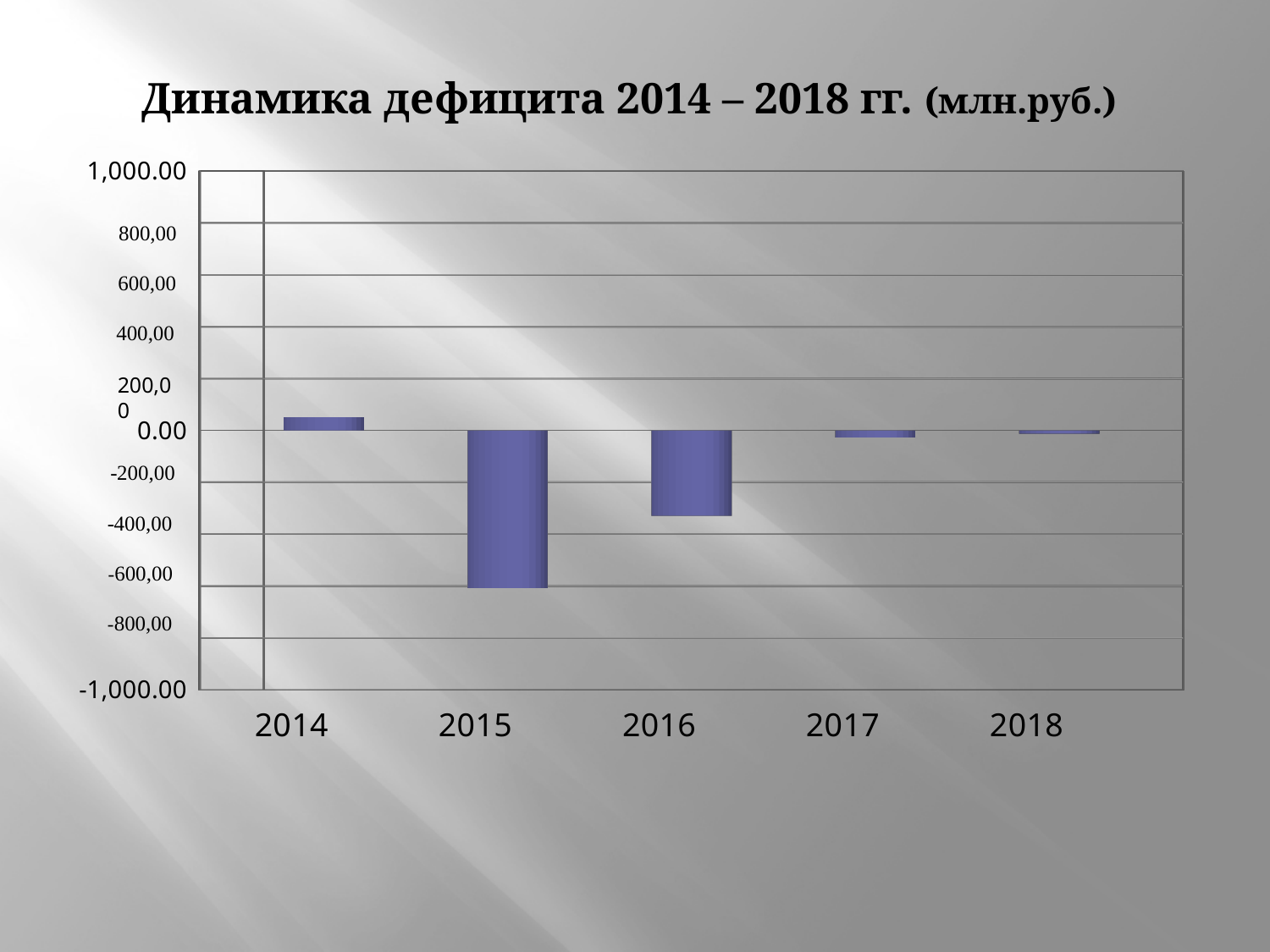
Is the value for 2015 greater or less than -400,00? less Is the value for 2016 greater or less than -200,00? less Is the value for 2017 greater or less than 0.00? less Which year has the highest value in the chart? 2014 Which year has the larger value, 2015 or 2016? 2016 What kind of chart is shown on the slide? bar chart Which year has the lowest (most negative) value in the chart? 2015 What is the highest value shown on the vertical axis of the chart? 1,000.00 What is the title of the chart? Динамика дефицита 2014 – 2018 гг. (млн.руб.) How many years are plotted on the x axis of the chart? 5